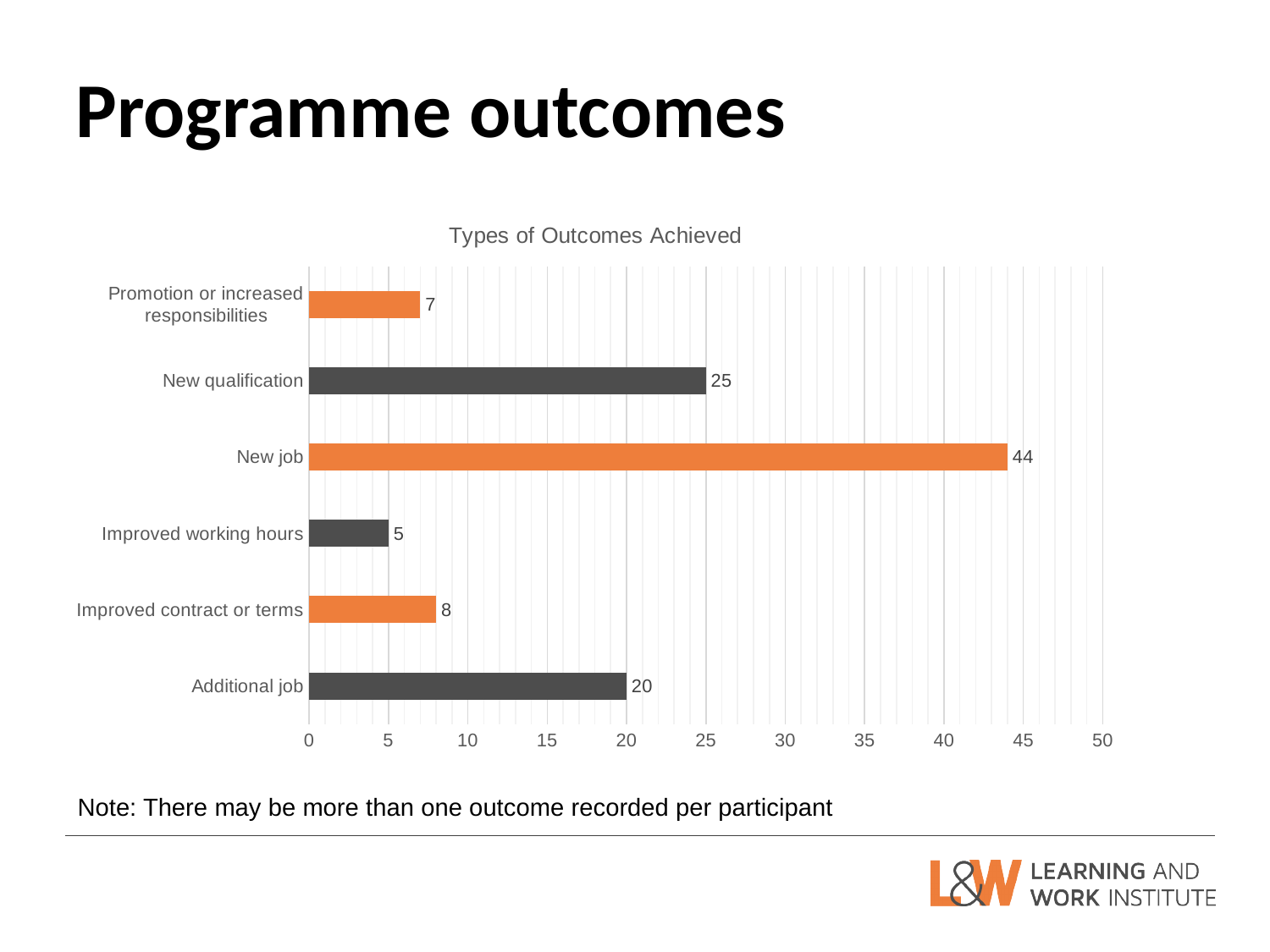
How many outcome categories are shown in the chart? 6 What is the value for Improved working hours? 5 What is the value for New qualification? 25 Which outcome has the lowest value? Improved working hours What is the value for New job? 44 What is the value for Additional job? 20 What kind of chart is shown on the slide? Bar chart What is the title of the chart? Types of Outcomes Achieved Is the value for Additional job greater or less than 15? greater Which outcome has the highest value? New job What is the difference between the values for New job and New qualification? 19 Which is larger, the value for Improved contract or terms or the value for Promotion or increased responsibilities? Improved contract or terms